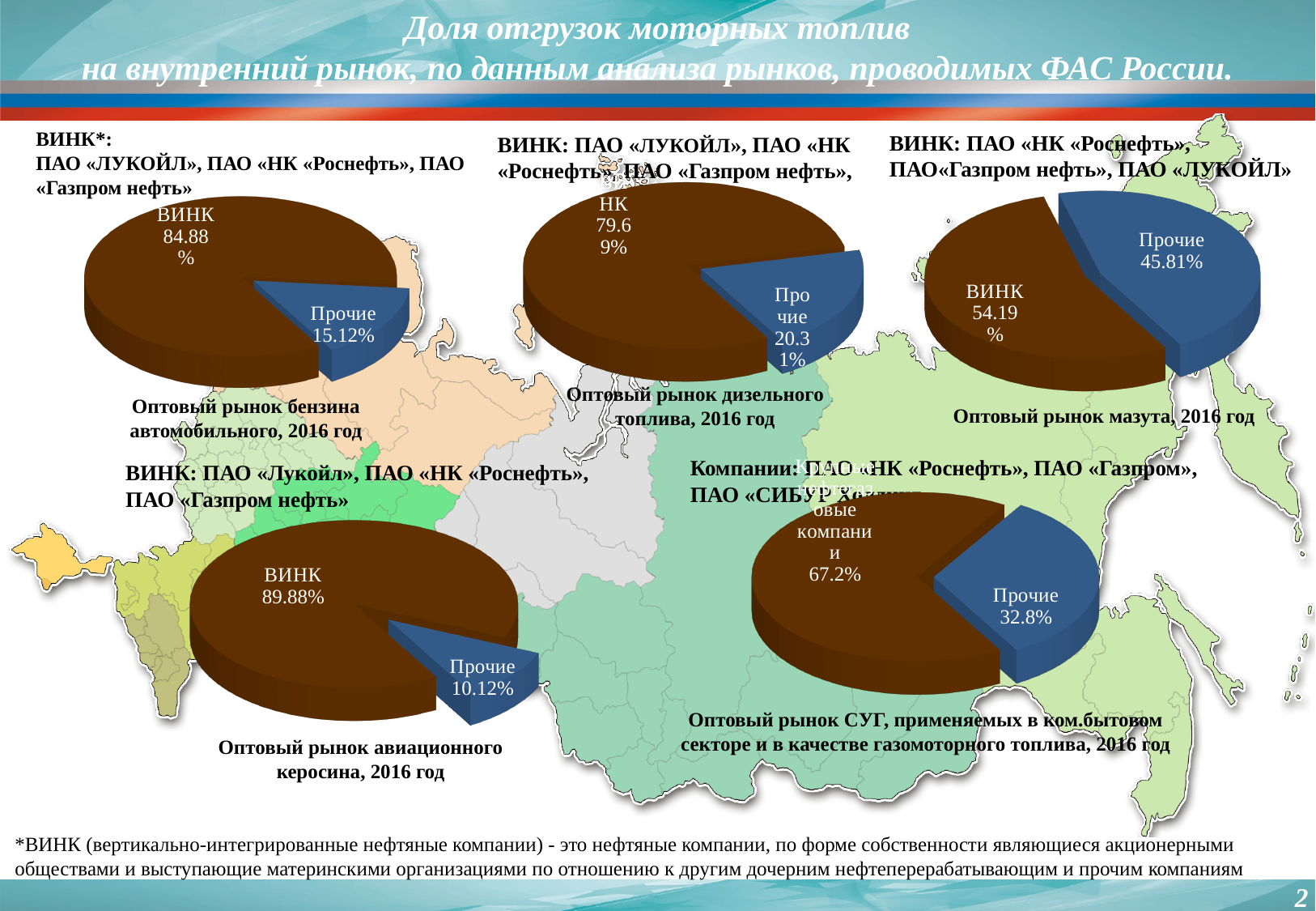
In the pie chart titled «Оптовый рынок авиационного керосина, 2016 год», what is the difference between the ВИНК share and the Прочие share? 79.76% How many slices does the pie chart titled «Оптовый рынок мазута, 2016 год» have? 2 In the pie chart titled «Оптовый рынок мазута, 2016 год», what share is shown for ВИНК? 54.19% In the pie chart titled «Оптовый рынок авиационного керосина, 2016 год», what share is shown for ВИНК? 89.88% In the pie chart titled «Оптовый рынок мазута, 2016 год», what share is shown for Прочие? 45.81% In the pie chart titled «Оптовый рынок бензина автомобильного, 2016 год», what share is shown for ВИНК? 84.88% In the pie chart titled «Оптовый рынок бензина автомобильного, 2016 год», what share is shown for Прочие? 15.12% In the pie chart titled «Оптовый рынок СУГ, применяемых в ком.бытовом секторе и в качестве газомоторного топлива, 2016 год», what share is shown for Прочие? 32.8% In the pie chart titled «Оптовый рынок дизельного топлива, 2016 год», what share is shown for Прочие? 20.31% In the pie chart titled «Оптовый рынок авиационного керосина, 2016 год», what share is shown for Прочие? 10.12% In the pie chart titled «Оптовый рынок мазута, 2016 год», which slice is larger, ВИНК or Прочие? ВИНК What type of chart is used for «Оптовый рынок бензина автомобильного, 2016 год»? Pie chart